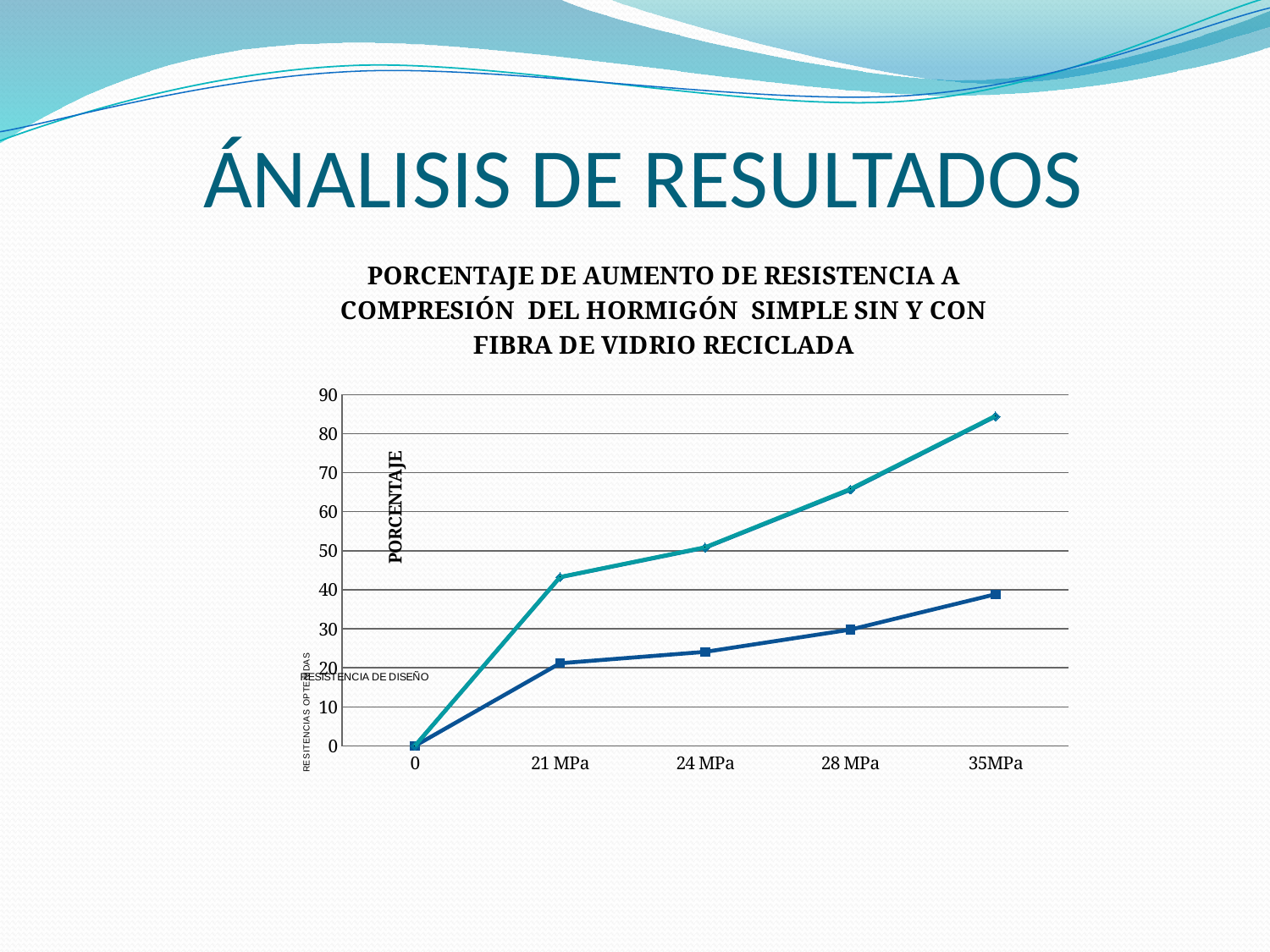
What is the label on the vertical axis of the chart? PORCENTAJE What kind of chart is shown on the slide? line chart Is the value of the teal (diamond-marker) line at 21 MPa greater or less than 40? greater At which x-axis category does the teal (diamond-marker) line reach its highest value? 35MPa Is the value of the teal (diamond-marker) line at 35MPa greater or less than 80? greater Do the values of the lower (dark blue, square-marker) line rise or fall along the x axis? rise How many lines (series) are plotted on the chart? 2 At 24 MPa, which line has the larger value, the teal (diamond-marker) line or the dark blue (square-marker) line? the teal (diamond-marker) line How many categories are shown along the x axis of the chart? 5 Do the values of the upper (teal, diamond-marker) line rise or fall from 0 to 35MPa? rise